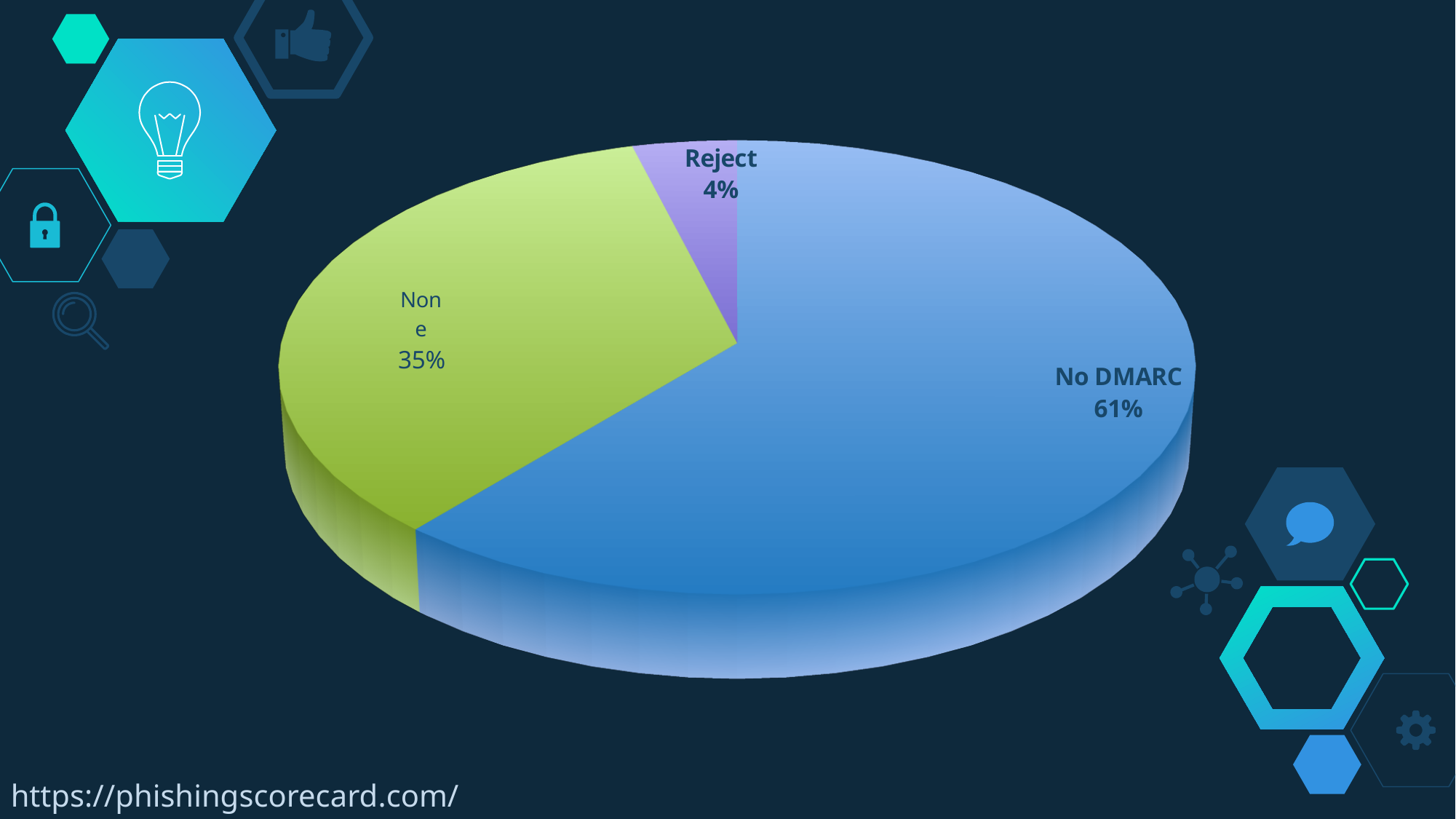
What is the difference in percentage points between the No DMARC slice and the None slice? 26 What percentage of the pie is labelled No DMARC? 61% What kind of chart is shown on the slide? Pie chart How many slices does the pie chart have? 3 What colour is the None slice? Green Which slice of the pie is the smallest? Reject What percentage of the pie is labelled Reject? 4% Which is larger, the None slice or the Reject slice? None Which slice of the pie is the largest? No DMARC What is the difference in percentage points between the None slice and the Reject slice? 31 What percentage of the pie is labelled None? 35% What colour is the No DMARC slice? Blue